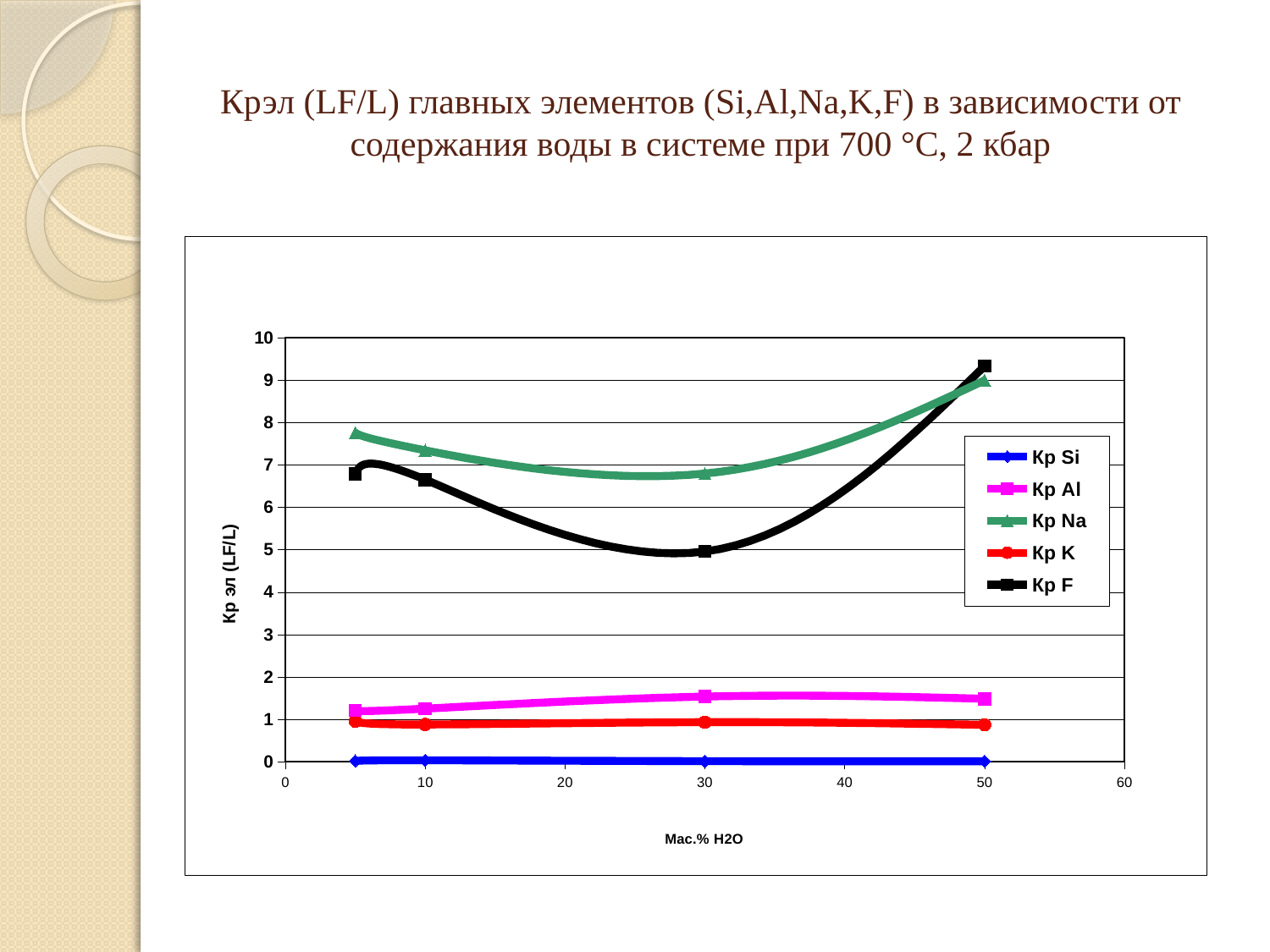
Is the value of Kp Na at 5 Mac.% H2O greater or less than 7? greater At which Mac.% H2O value does the Kp F series reach its lowest point? 30 How many data points are plotted for the Kp F series? 4 Does the Kp F series rise or fall between 30 and 50 Mac.% H2O? rise Is the value of Kp F at 30 Mac.% H2O greater or less than 6? less How many series does the legend list? 5 Is the value of Kp Na at 50 Mac.% H2O greater or less than 8? greater Which series has the lowest values across the whole chart? Kp Si Which series has the highest value at 30 Mac.% H2O? Kp Na What is the title of the vertical axis? Kp эл (LF/L) At 30 Mac.% H2O, which is larger: Kp Al or Kp K? Kp Al What kind of chart is shown on the slide? line chart